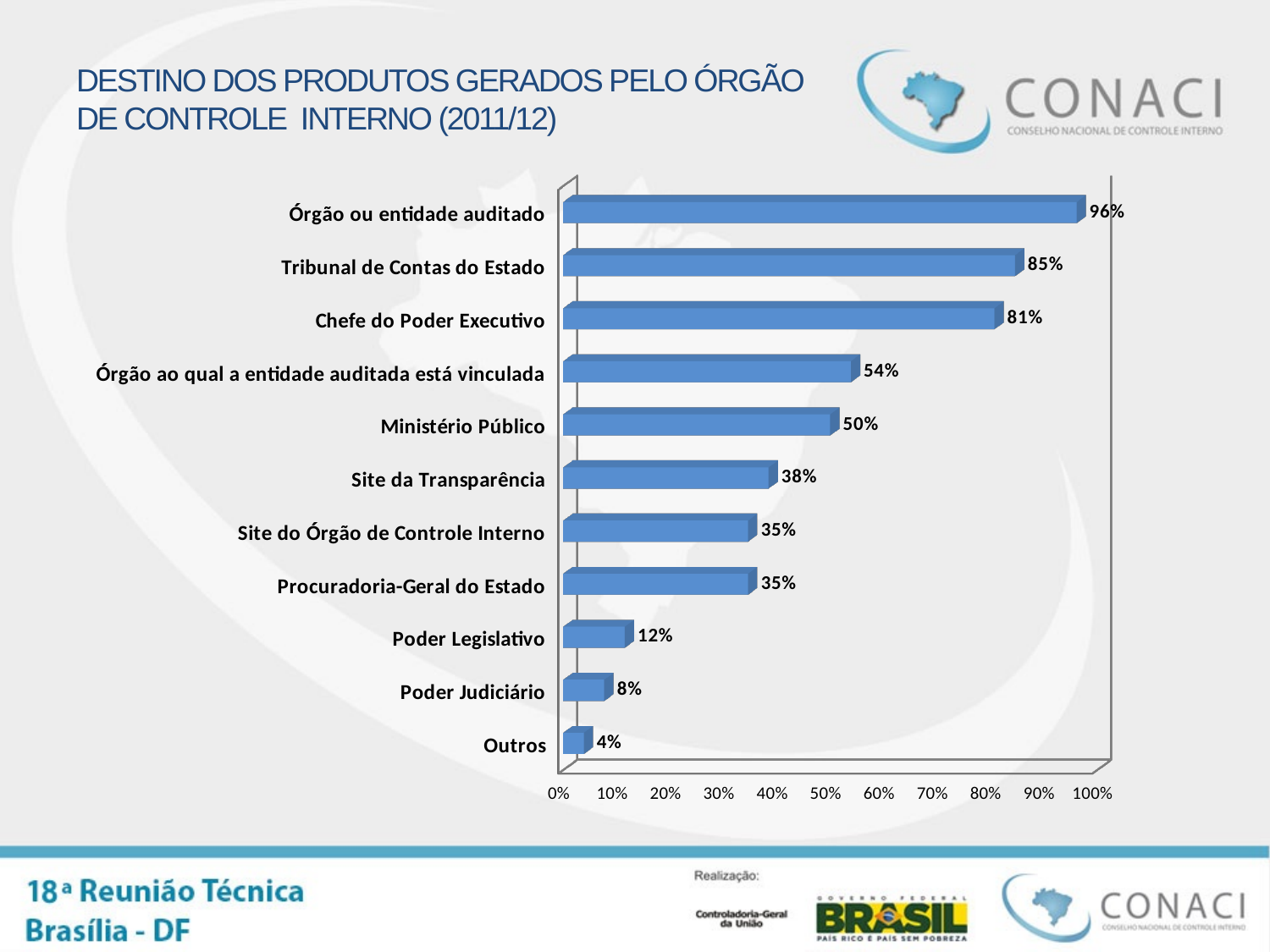
Which category has the highest value? Órgão ou entidade auditado What is the value for Órgão ou entidade auditado? 96% How many categories are shown in the chart? 11 What is the difference between the values for Órgão ou entidade auditado and Outros? 92% Is the value for Órgão ao qual a entidade auditada está vinculada greater or less than 50%? greater Which is larger, the value for Site da Transparência or the value for Poder Judiciário? Site da Transparência What kind of chart is shown on the slide? bar chart Which category has the lowest value? Outros What is the value for Poder Legislativo? 12% What is the title of the slide containing the chart? DESTINO DOS PRODUTOS GERADOS PELO ÓRGÃO DE CONTROLE INTERNO (2011/12) What is the difference between the values for Tribunal de Contas do Estado and Chefe do Poder Executivo? 4% What is the value for Ministério Público? 50%